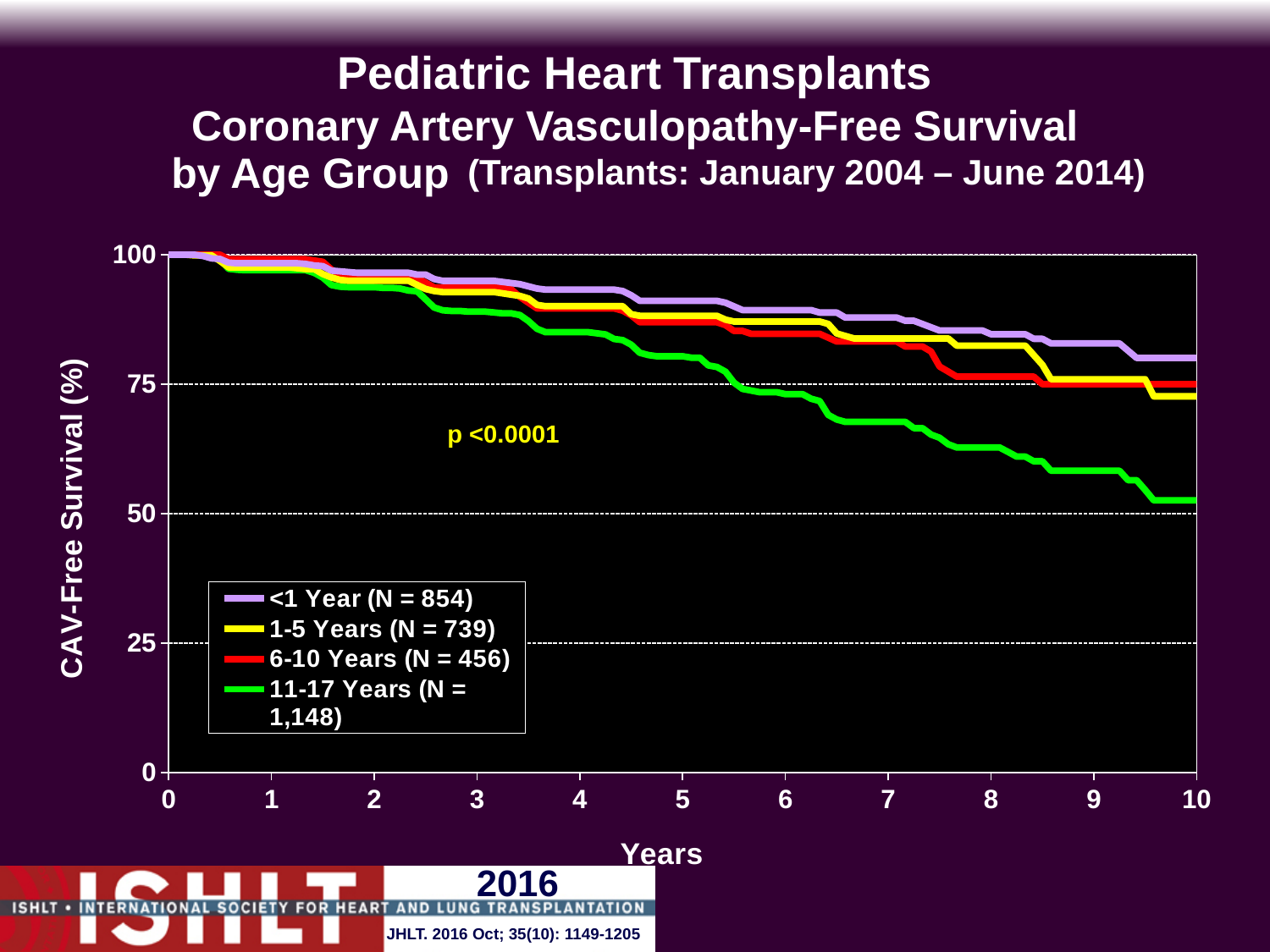
Which age group has the highest CAV-free survival at 10 years? <1 Year Do the CAV-free survival curves rise or fall as years since transplant increase? fall Is the CAV-free survival for the <1 Year group at 10 years greater or less than 75? greater At 10 years, which group has higher CAV-free survival: <1 Year or 11-17 Years? <1 Year Is the CAV-free survival for the 11-17 Years group at 8 years greater or less than 50? greater What p-value is printed on the chart? p <0.0001 What kind of chart is shown on the slide? line chart Which age group has the lowest CAV-free survival at 10 years? 11-17 Years How many age groups does the legend list? 4 Is the CAV-free survival for the 11-17 Years group at 6 years greater or less than 75? less What is the N for the 11-17 Years group shown in the legend? 1,148